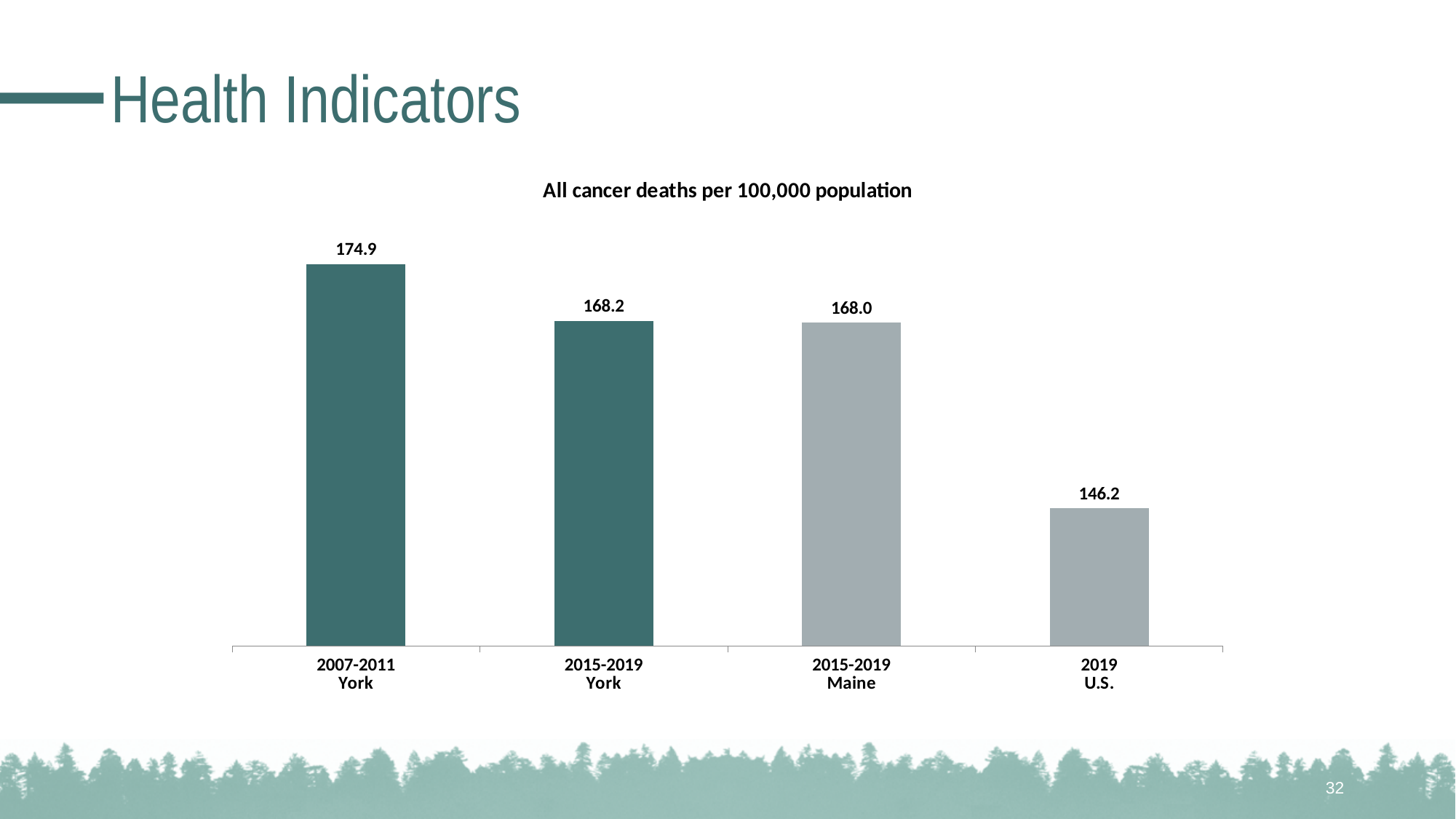
What is the difference between the 2015-2019 Maine value and the 2019 U.S. value? 21.8 Which is larger, the value for 2007-2011 York or the value for 2019 U.S.? 2007-2011 York What is the value for 2007-2011 York? 174.9 What kind of chart is shown on the slide? Bar chart What is the difference between the 2007-2011 York value and the 2015-2019 York value? 6.7 How many bars are shown in the chart? 4 Which category has the highest value? 2007-2011 York What is the value for 2019 U.S.? 146.2 Which category has the lowest value? 2019 U.S. What is the value for 2015-2019 Maine? 168.0 What is the value for 2015-2019 York? 168.2 What is the title of the chart? All cancer deaths per 100,000 population